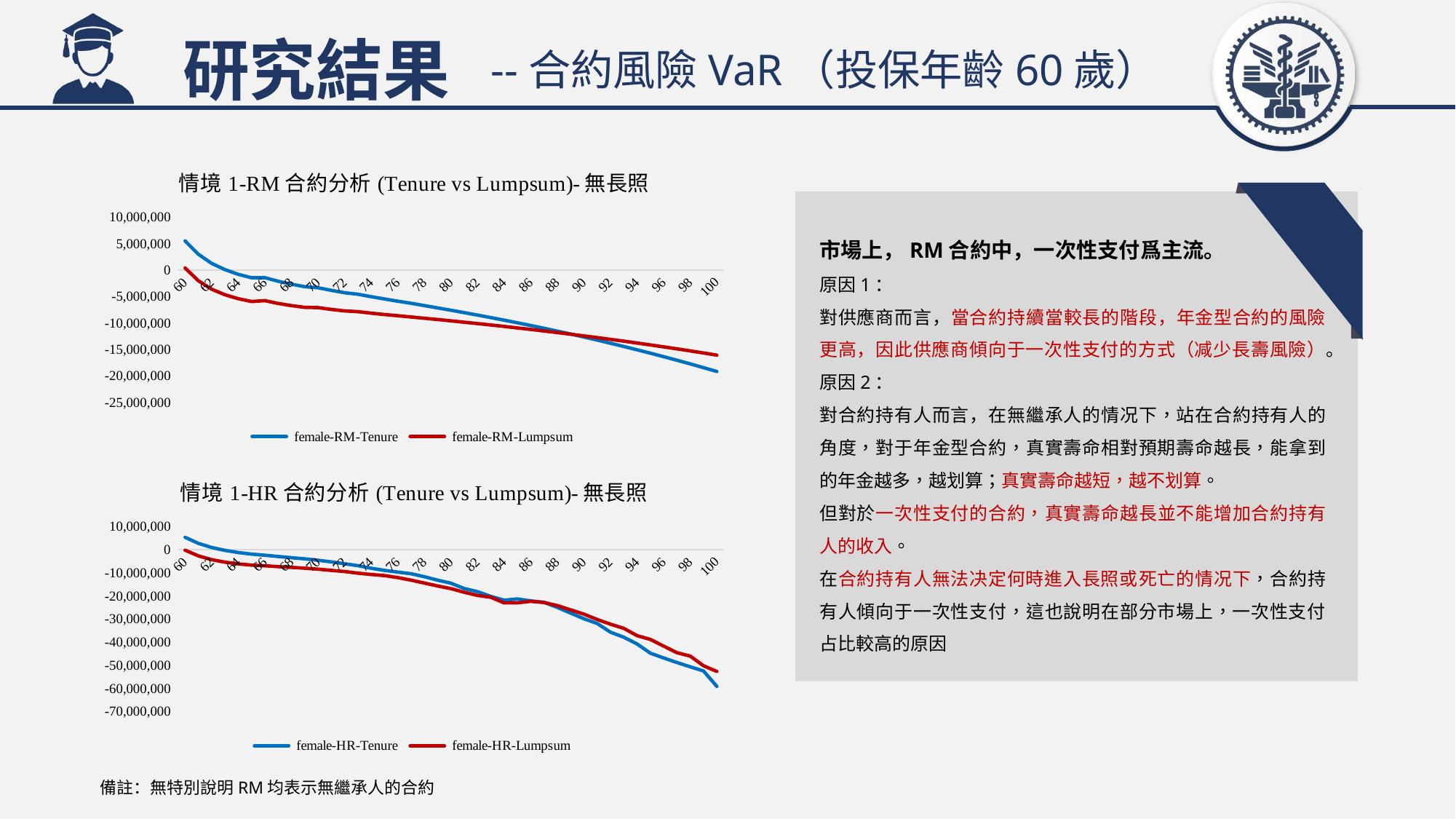
What are the two legend entries of the bottom chart (情境 1-HR 合約分析)? female-HR-Tenure and female-HR-Lumpsum In the top chart (情境 1-RM 合約分析), is the value for female-RM-Tenure at age 100 greater or less than -15,000,000? less In the top chart (情境 1-RM 合約分析), is the value for female-RM-Tenure at age 60 greater or less than 0? greater In the top chart (情境 1-RM 合約分析), at age 100, which series has the higher value, female-RM-Tenure or female-RM-Lumpsum? female-RM-Lumpsum In the top chart (情境 1-RM 合約分析), at age 70, which series has the higher value, female-RM-Tenure or female-RM-Lumpsum? female-RM-Tenure In the top chart (情境 1-RM 合約分析), do the values of female-RM-Tenure rise or fall as age increases from 60 to 100? fall In the top chart (情境 1-RM 合約分析), which colour is the female-RM-Lumpsum line? red In the bottom chart (情境 1-HR 合約分析), is the value for female-HR-Tenure at age 100 greater or less than -50,000,000? less What kind of chart is the top chart titled 情境 1-RM 合約分析 (Tenure vs Lumpsum)- 無長照? line chart How many series does the legend of the top chart (情境 1-RM 合約分析) list? 2 In the bottom chart (情境 1-HR 合約分析), do the values of female-HR-Lumpsum rise or fall as age increases from 60 to 100? fall